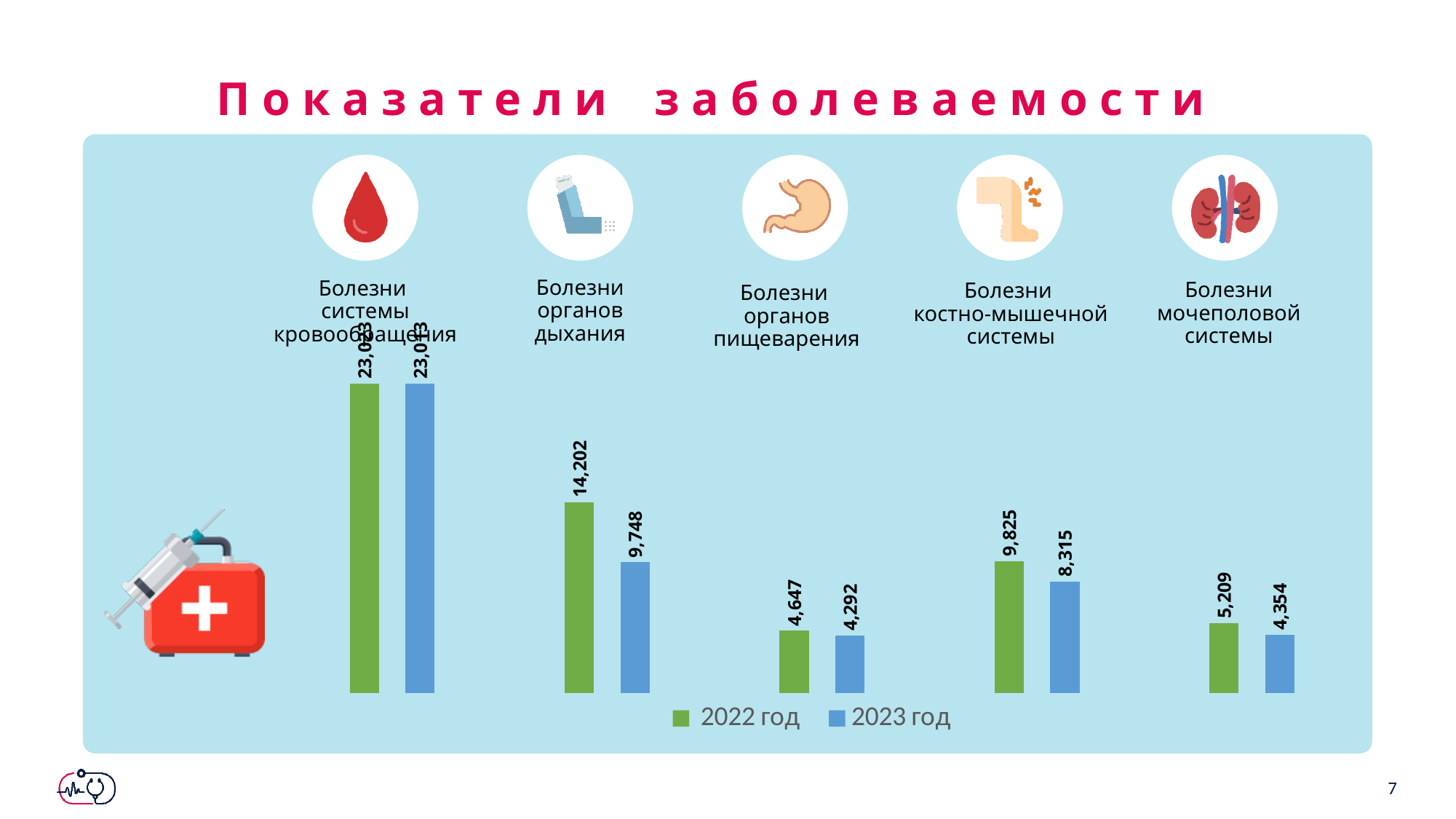
What is the difference between the 2022 год and 2023 год values for Болезни органов дыхания? 4,454 Which category has the highest 2022 год value? Болезни системы кровообращения How many disease categories are shown in the chart? 5 Which category has the lowest 2023 год value? Болезни органов пищеварения What type of chart is shown on the slide? Bar chart What is the 2023 год value for Болезни мочеполовой системы? 4,354 What is the 2022 год value for Болезни костно-мышечной системы? 9,825 What is the 2022 год value for Болезни органов пищеварения? 4,647 What is the 2023 год value for Болезни органов дыхания? 9,748 Which is larger for Болезни мочеполовой системы: the 2022 год value or the 2023 год value? 2022 год How many series does the legend list? 2 What is the 2023 год value for Болезни системы кровообращения? 23,013